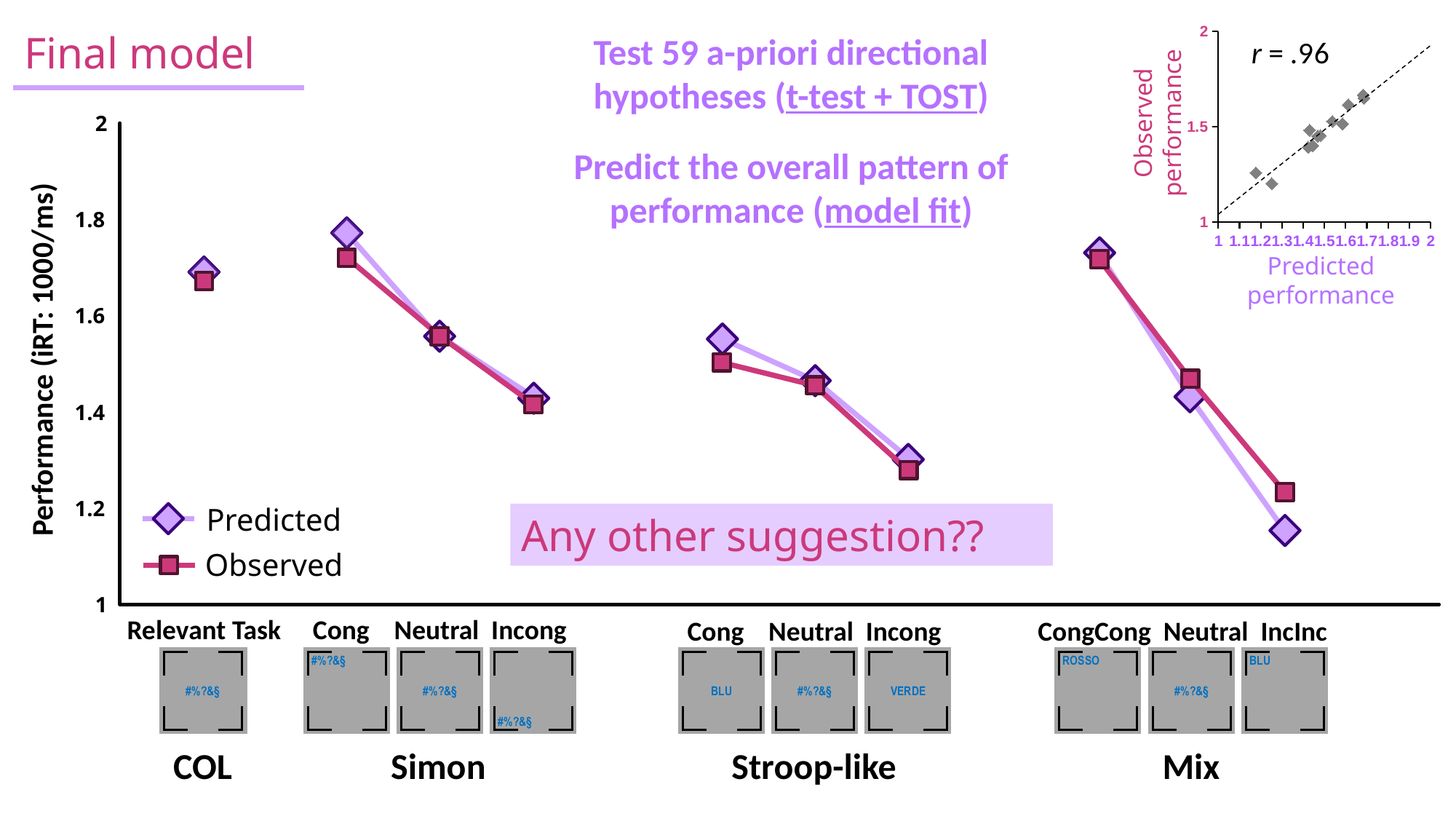
On the main line chart, is the Observed value for Stroop-like Incong greater or less than 1.4? less What kind of chart is the small inset chart in the top-right corner? Scatter plot On the main line chart, is the Predicted value for Simon Cong greater or less than 1.6? greater On the main line chart, how many series does the legend list? 2 On the main line chart, for Simon Cong, which is higher: the Predicted or the Observed value? Predicted On the main line chart, which condition has the lowest Predicted value? Mix IncInc What correlation value is printed on the inset scatter plot? r = .96 On the main line chart, for Mix IncInc, which is higher: the Predicted or the Observed value? Observed On the main line chart, do the Simon values rise or fall from Cong to Incong? fall On the main line chart, is the Observed value for Mix CongCong greater or less than 1.6? greater What kind of chart is the large chart on the left of the slide? Line chart On the main line chart, how many conditions are plotted along the x axis? 10